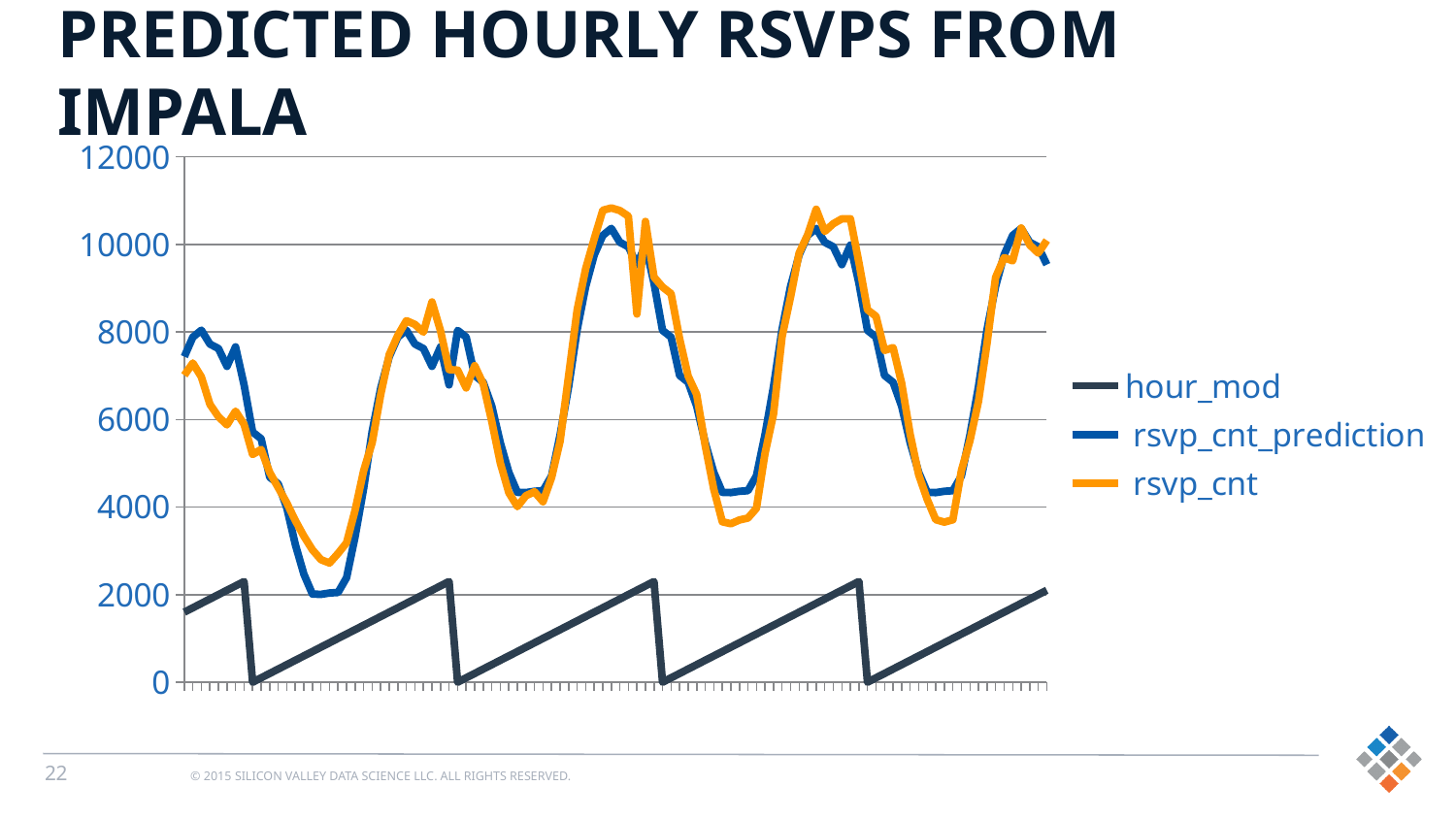
Which series stays lowest across the whole chart? hour_mod Which series is drawn in orange? rsvp_cnt Is the lowest value reached by rsvp_cnt_prediction greater or less than 4000? less What is the interval between consecutive tick labels on the vertical axis? 2000 Which is larger at its peak, hour_mod or rsvp_cnt_prediction? rsvp_cnt_prediction Is the lowest value reached by rsvp_cnt greater or less than 2000? greater Is the highest value reached by rsvp_cnt greater or less than 10000? greater How many series does the legend list? 3 What is the highest value shown on the vertical axis? 12000 What kind of chart is shown on the slide? line chart What is the title of the chart? PREDICTED HOURLY RSVPS FROM IMPALA